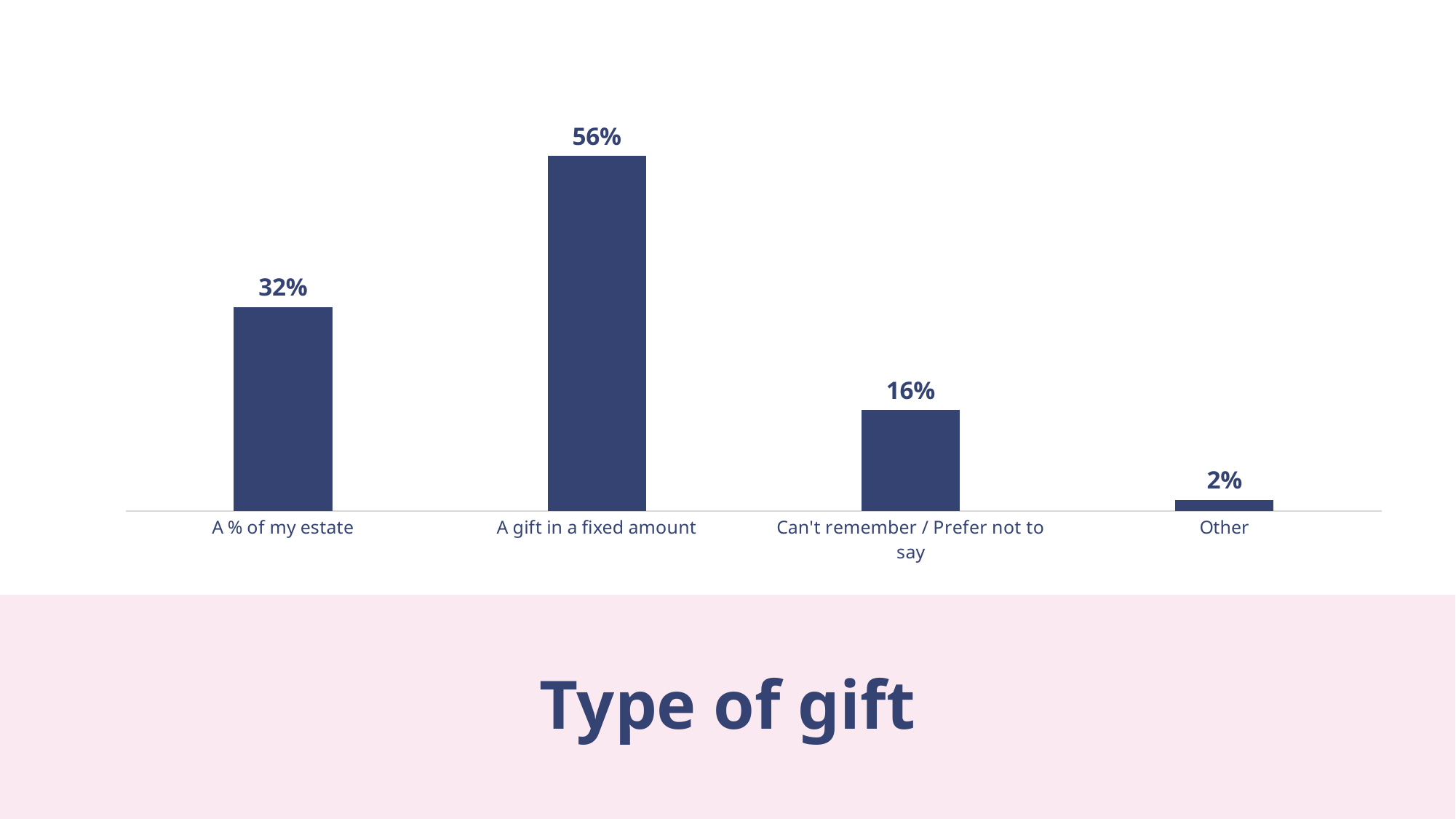
What kind of chart is shown on the slide? Bar chart Which is larger, 'A % of my estate' or 'Can't remember / Prefer not to say'? A % of my estate What is the title shown below the chart? Type of gift What is the value for 'A gift in a fixed amount'? 56% Which type of gift has the lowest value? Other How many categories are shown in the chart? 4 What is the difference between 'A gift in a fixed amount' and 'A % of my estate'? 24% What is the value for 'A % of my estate'? 32% What is the value for 'Can't remember / Prefer not to say'? 16% Which type of gift has the highest value? A gift in a fixed amount What is the difference between 'A % of my estate' and 'Can't remember / Prefer not to say'? 16% What is the value for 'Other'? 2%